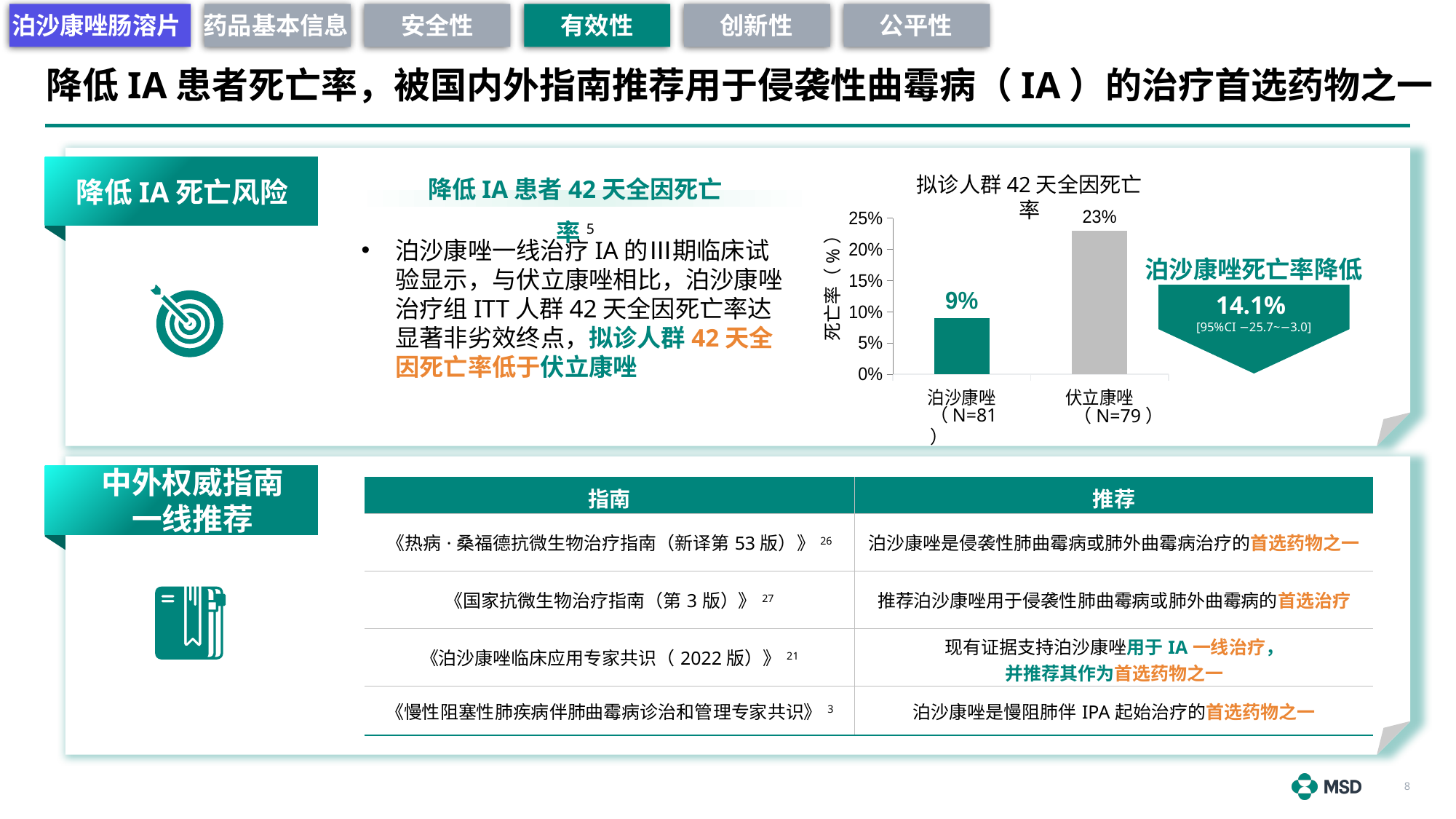
Which treatment group has the lower mortality rate in the bar chart? 泊沙康唑 What is the highest value shown on the y-axis of the bar chart? 25% What is the 42-day all-cause mortality rate shown for 泊沙康唑 in the bar chart? 9% What is the sample size (N) shown for the 泊沙康唑 group in the bar chart? N=81 Which treatment group has the higher mortality rate in the bar chart? 伏立康唑 What type of chart is used to show the 42-day all-cause mortality rates? bar chart Is the mortality rate for 伏立康唑 greater or less than 20%? greater What is the title of the bar chart? 拟诊人群42天全因死亡率 Is the mortality rate for 泊沙康唑 greater or less than 10%? less What is the difference in mortality rate between 伏立康唑 and 泊沙康唑 in the bar chart? 14 percentage points What is the 42-day all-cause mortality rate shown for 伏立康唑 in the bar chart? 23% How many treatment groups are plotted in the bar chart? 2